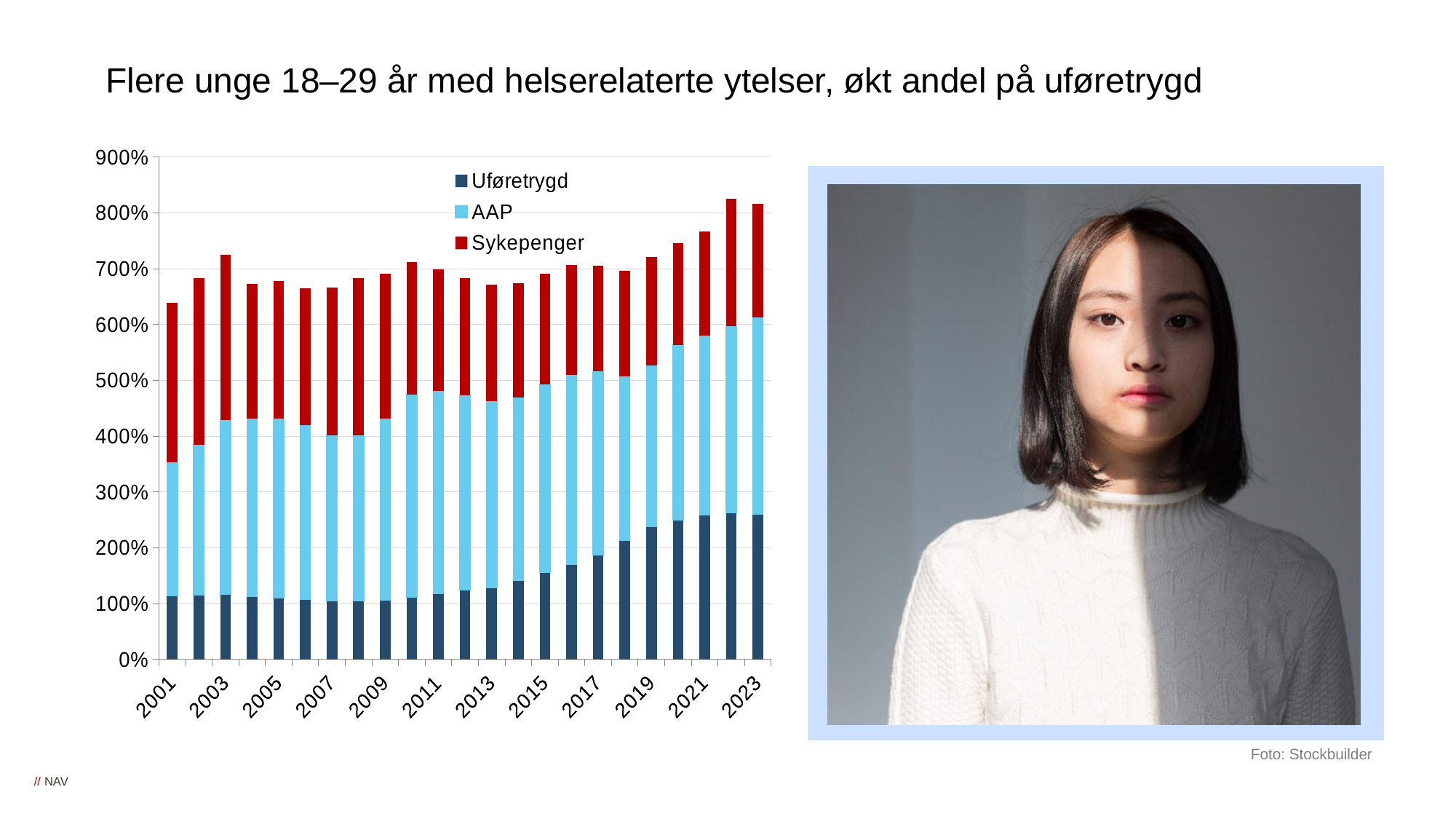
Is the total stacked bar for 2001 greater or less than 700%? less Which year has the lowest total stacked bar? 2001 How many years (bars) are plotted in the chart? 23 Is the Uføretrygd value for 2001 greater or less than 200%? less Does the Uføretrygd segment rise or fall from 2013 to 2023? Rises Which year has the highest total stacked bar? 2022 What kind of chart is shown on the slide? Stacked bar chart Which series are listed in the legend? Uføretrygd, AAP, Sykepenger Which is larger, the Uføretrygd value for 2023 or for 2001? 2023 Is the Uføretrygd value for 2023 greater or less than 200%? greater How many series does the legend list? 3